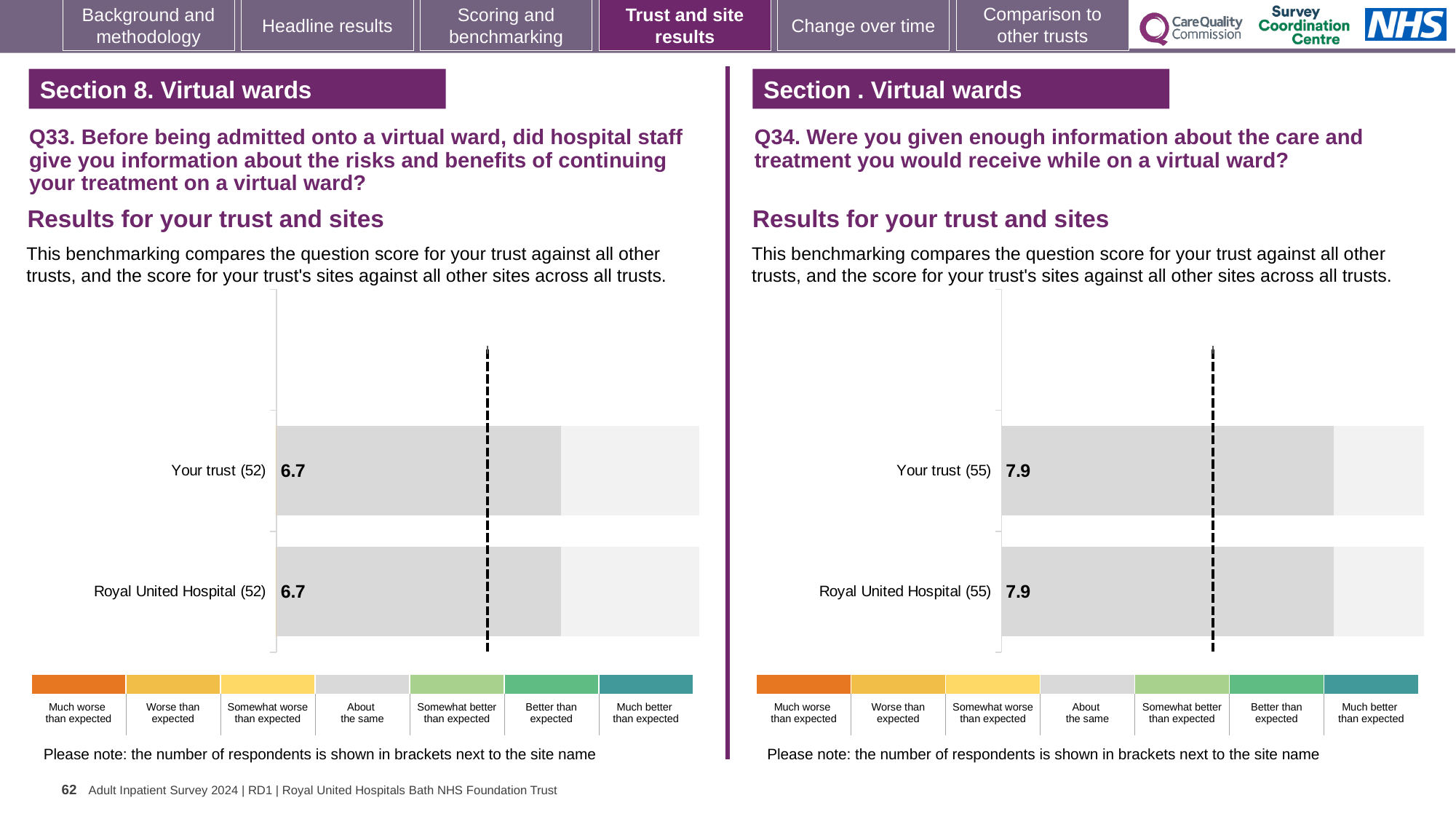
How many benchmark categories does the colour key below the left chart (Q33) list? 7 In the left chart (Q33), what is the difference between the scores for Your trust and Royal United Hospital? 0 How many bars are plotted in the left chart (Q33)? 2 How many respondents are shown in brackets for Royal United Hospital in the right chart (Q34)? 55 What kind of chart is used in the left chart (Q33)? Bar chart In the left chart (Q33), what is the score for Royal United Hospital (52)? 6.7 What is the difference between the Your trust score in the right chart (Q34) and the Your trust score in the left chart (Q33)? 1.2 In the right chart (Q34), what is the score for Royal United Hospital (55)? 7.9 How many bars are plotted in the right chart (Q34)? 2 In the right chart (Q34), what is the score for Your trust (55)? 7.9 In the left chart (Q33), what is the score for Your trust (52)? 6.7 Which is larger: the Your trust score in the left chart (Q33) or the Your trust score in the right chart (Q34)? The right chart (Q34), 7.9